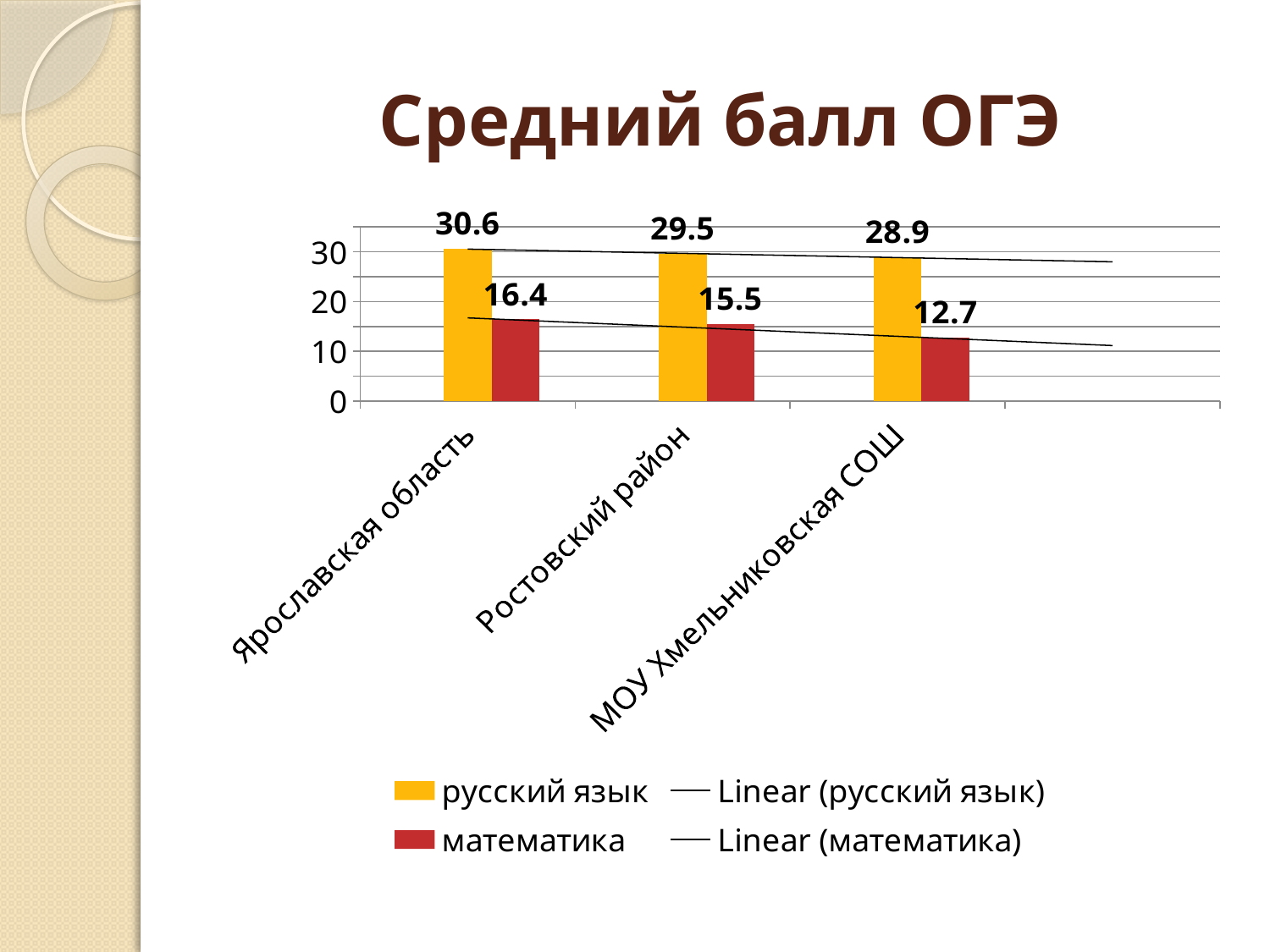
How many categories are shown on the x axis? 3 Which is larger: the русский язык score for Ростовский район or for МОУ Хмельниковская СОШ? Ростовский район What is the value for математика in Ростовский район? 15.5 Which category has the highest value for русский язык? Ярославская область What is the difference between the русский язык and математика scores for Ярославская область? 14.2 What is the average OGE score in русский язык for Ярославская область? 30.6 How many entries does the legend list? 4 Which category has the lowest value for математика? МОУ Хмельниковская СОШ What kind of chart is shown on the slide? Bar chart By how much does the математика score for Ростовский район exceed that of МОУ Хмельниковская СОШ? 2.8 What is the average OGE score in математика for МОУ Хмельниковская СОШ? 12.7 Do the математика values rise or fall from left to right along the x axis? Fall